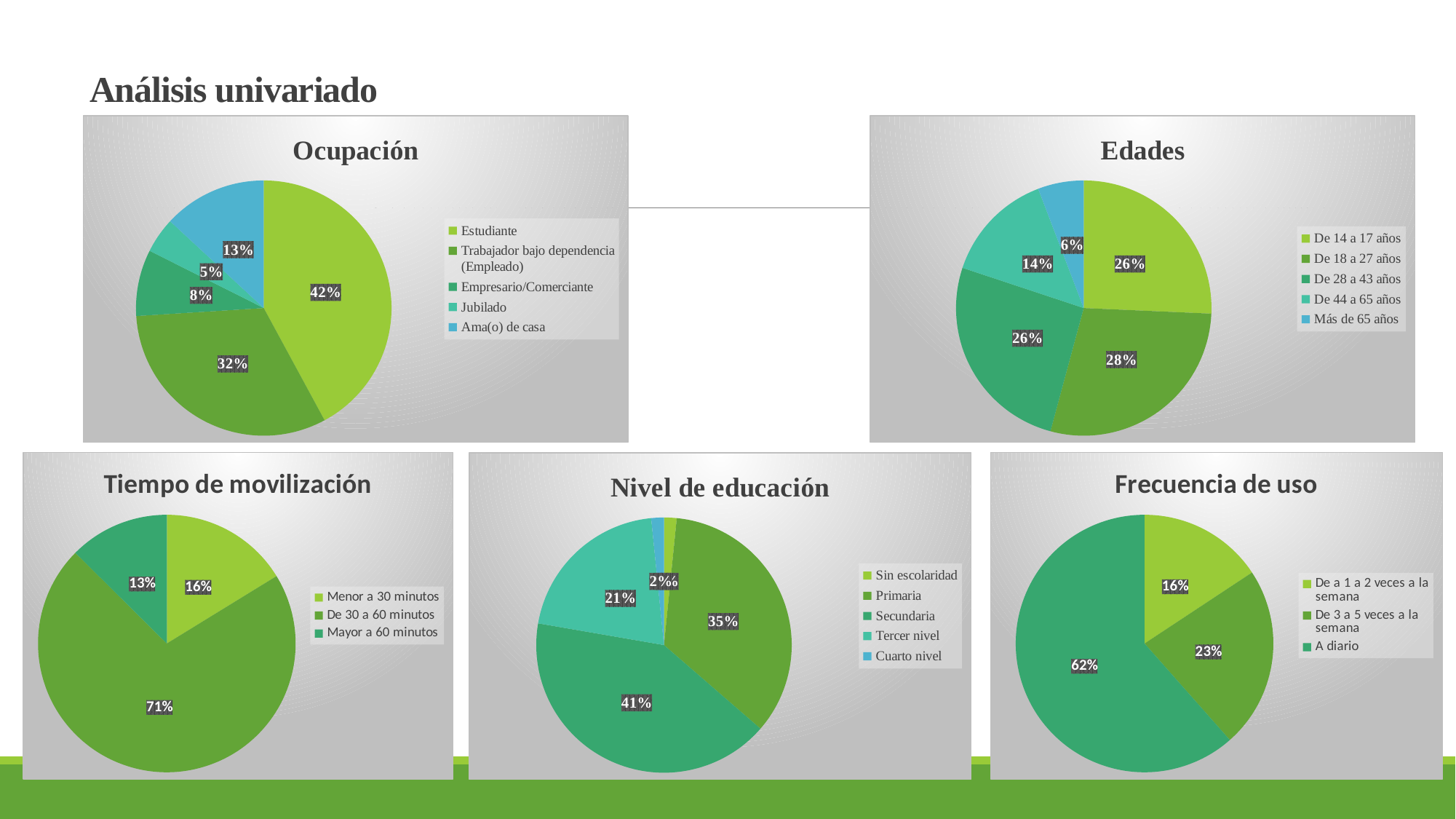
In the Nivel de educación chart, which category has the largest share? Secundaria What type of chart is the Frecuencia de uso chart? Pie chart In the Nivel de educación chart, what percentage is shown for Secundaria? 41% How many categories does the legend of the Edades chart list? 5 In the Ocupación chart, what is the difference between the Estudiante and Trabajador bajo dependencia (Empleado) shares? 10% In the Edades chart, what percentage is shown for De 18 a 27 años? 28% In the Ocupación chart, which category has the smallest share? Jubilado In the Edades chart, which age group has the smallest share? Más de 65 años In the Tiempo de movilización chart, which is larger: Menor a 30 minutos or Mayor a 60 minutos? Menor a 30 minutos In the Ocupación chart, what percentage is shown for Estudiante? 42% In the Tiempo de movilización chart, what percentage is shown for De 30 a 60 minutos? 71% In the Frecuencia de uso chart, what percentage is shown for A diario? 62%